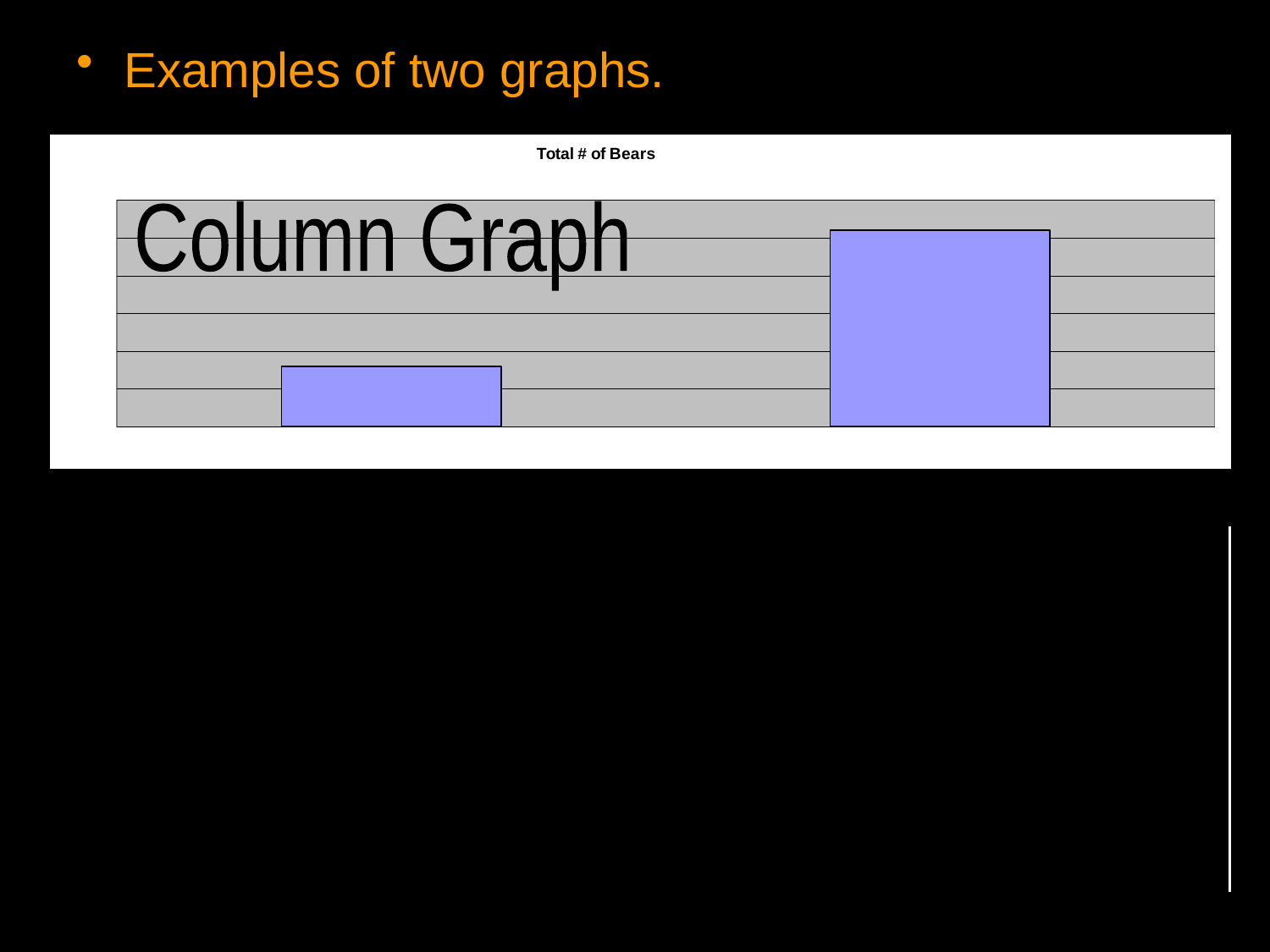
What kind of chart is shown on the slide? bar chart What is the title of the chart? Total # of Bears Which bar is taller, the left bar or the right bar? the right bar How many bars are plotted in the chart? 2 What colour are the bars in the chart? blue